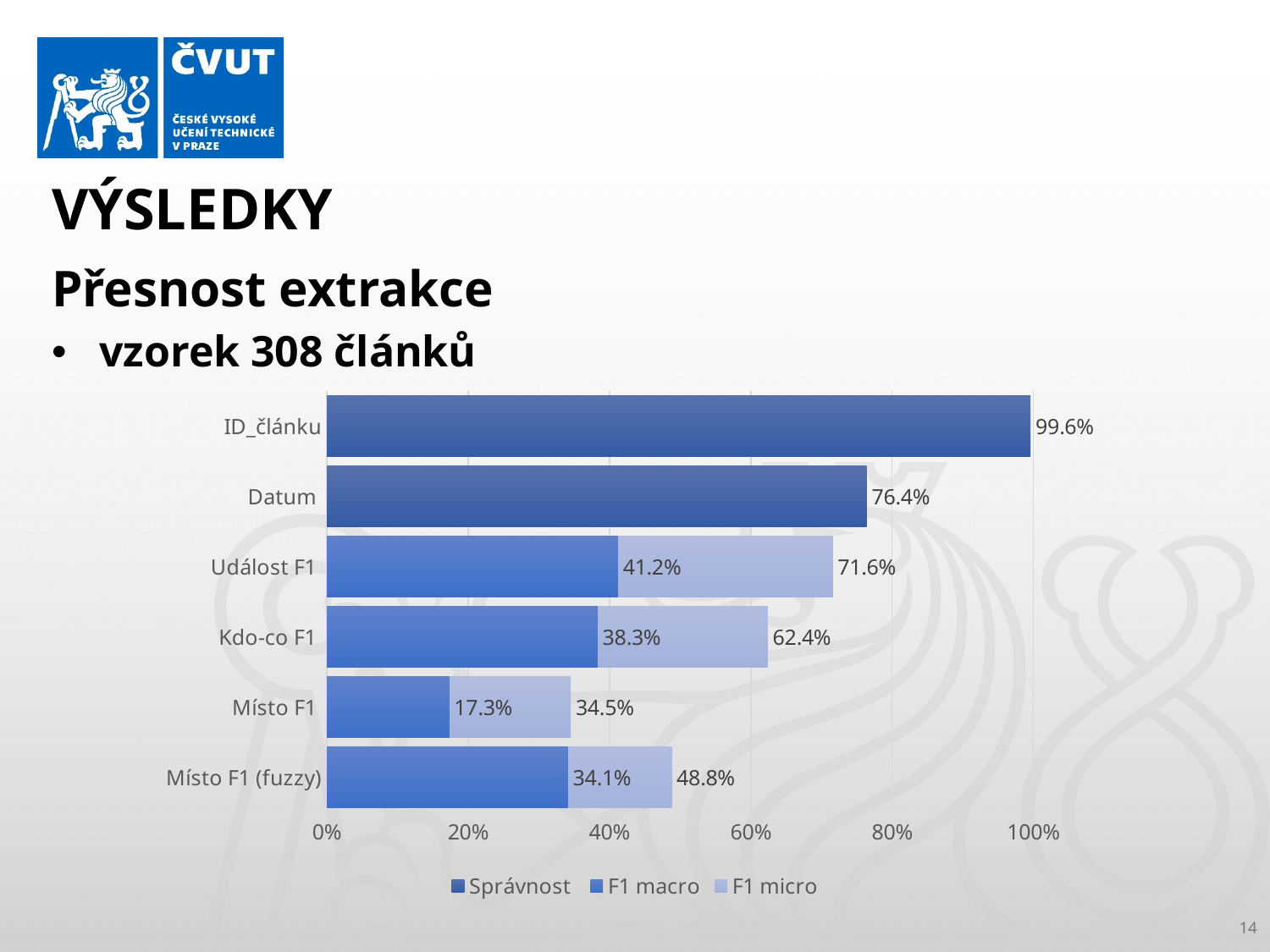
What is the Správnost value for Datum? 76.4% What is the Správnost value for ID_článku? 99.6% What kind of chart is shown on the slide? Bar chart How many categories are shown on the y axis of the chart? 6 How many series does the chart legend list? 3 What is the F1 micro value for Místo F1 (fuzzy)? 48.8% What is the F1 macro value for Událost F1? 41.2% Which category has the lowest F1 macro value? Místo F1 Which category has the highest value shown in the chart? ID_článku What is the difference between the F1 micro and F1 macro values for Událost F1? 30.4% What is the F1 micro value for Kdo-co F1? 62.4% Which is larger: the F1 micro value for Místo F1 or the F1 macro value for Místo F1 (fuzzy)? F1 micro for Místo F1